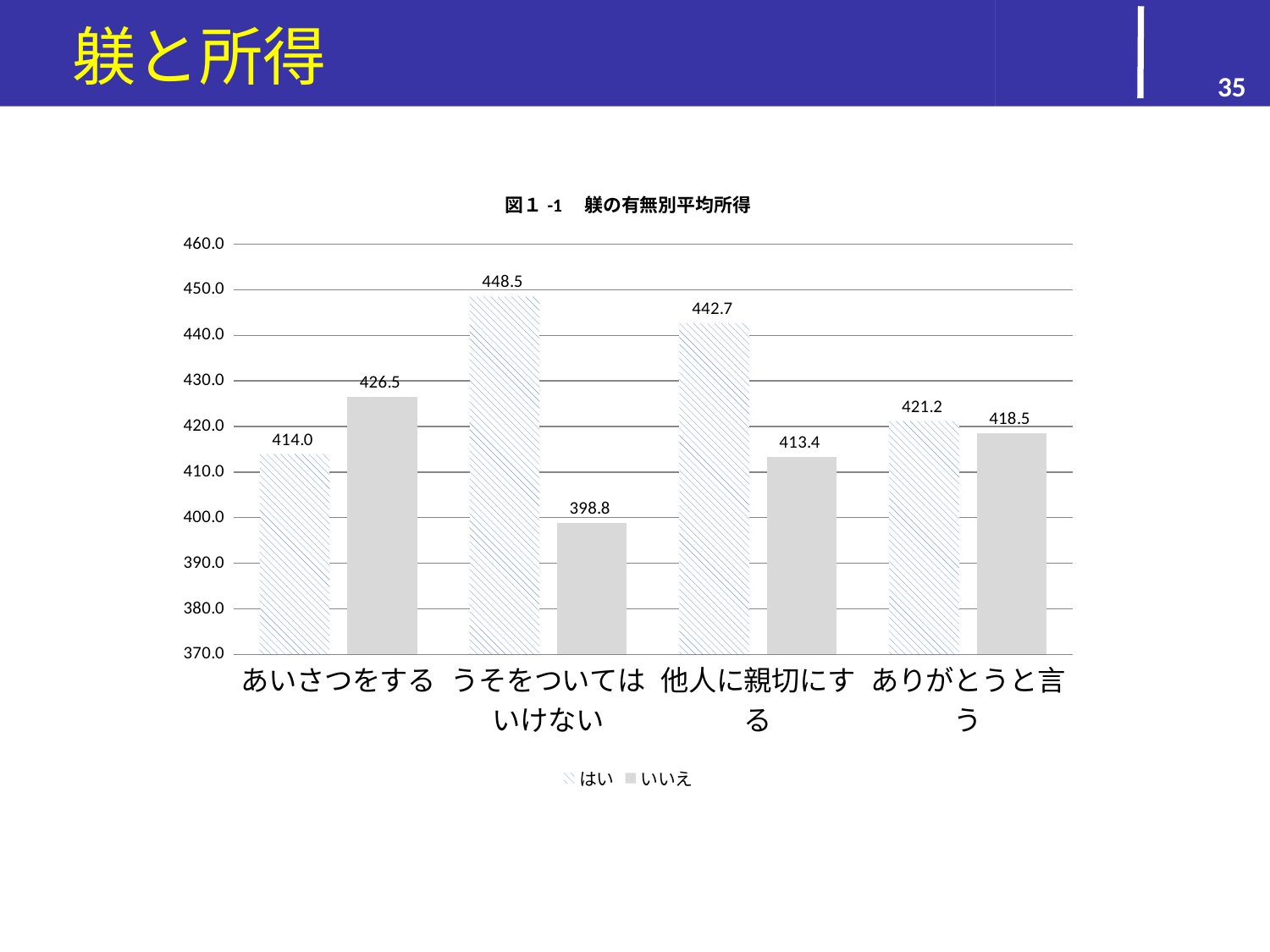
What is the value for はい in the あいさつをする category? 414.0 Which category has the highest はい value? うそをついてはいけない In the あいさつをする category, which is larger, はい or いいえ? いいえ What is the value for いいえ in the ありがとうと言う category? 418.5 What is the difference between the はい and いいえ values in the うそをついてはいけない category? 49.7 Which category has the lowest いいえ value? うそをついてはいけない How many series does the legend list? 2 What is the value for いいえ in the うそをついてはいけない category? 398.8 What is the title of the chart? 図１-1 躾の有無別平均所得 What is the value for はい in the 他人に親切にする category? 442.7 How many categories are shown on the x axis? 4 What kind of chart is shown on the slide? Bar chart